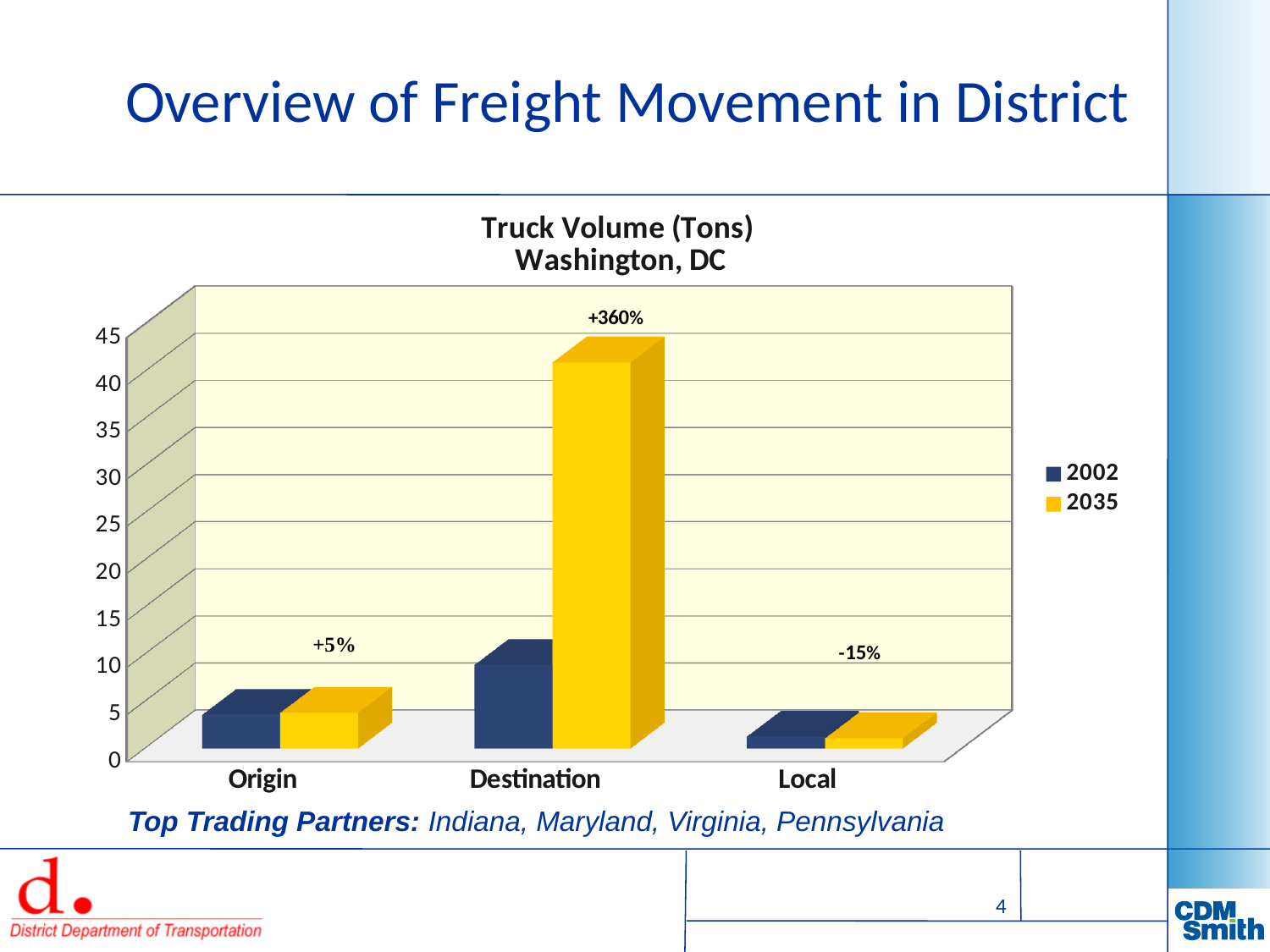
Is the 2002 value for Destination greater or less than 15? less What is the title of the chart? Truck Volume (Tons) Washington, DC What percentage change is labelled above the Local bars? -15% What percentage change is labelled above the Destination bars? +360% Is the 2035 value for Destination greater or less than 35? greater Which series is shown in yellow? 2035 What percentage change is labelled above the Origin bars? +5% How many categories are shown on the x axis? 3 Which category has the lowest 2035 truck volume? Local How many series does the legend list? 2 What type of chart is shown on the slide? bar chart Which category has the highest 2035 truck volume? Destination